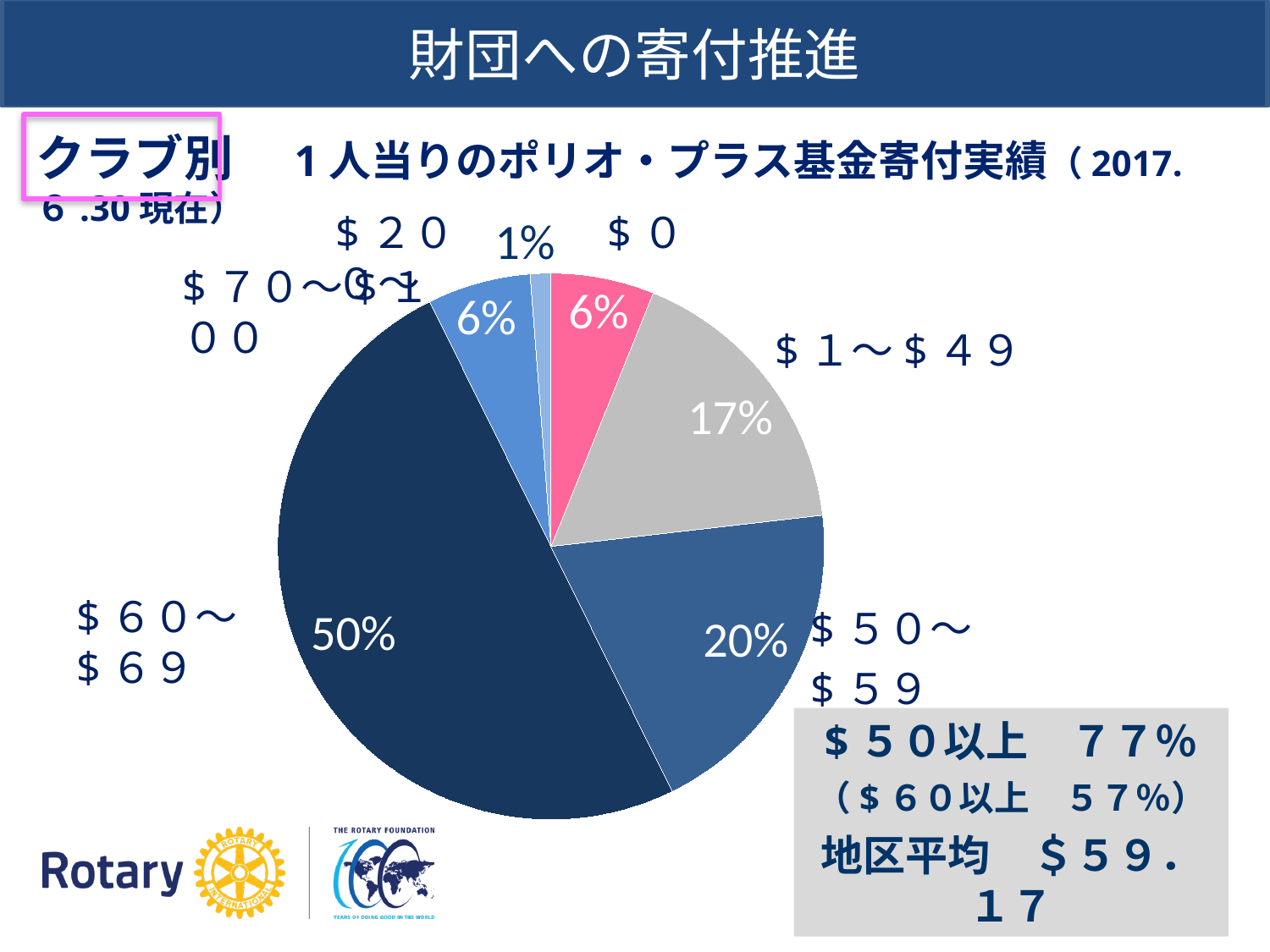
What kind of chart is shown on the slide? pie chart What percentage of the pie is the $６０～$６９ slice? 50% What percentage does the text box on the slide give for $５０以上? ７７％ Which category has the largest slice of the pie? $６０～$６９ What percentage of the pie is the $１～$４９ slice? 17% What percentage of the pie is the $５０～$５９ slice? 20% Which slice is larger, $１～$４９ or $５０～$５９? $５０～$５９ How many percentage points larger is the $６０～$６９ slice than the $５０～$５９ slice? 30 percentage points How many slices does the pie chart have? 6 What percentage of the pie is the $０ slice? 6% What is the percentage shown on the smallest slice of the pie? 1% How many percentage points larger is the $１～$４９ slice than the $０ slice? 11 percentage points